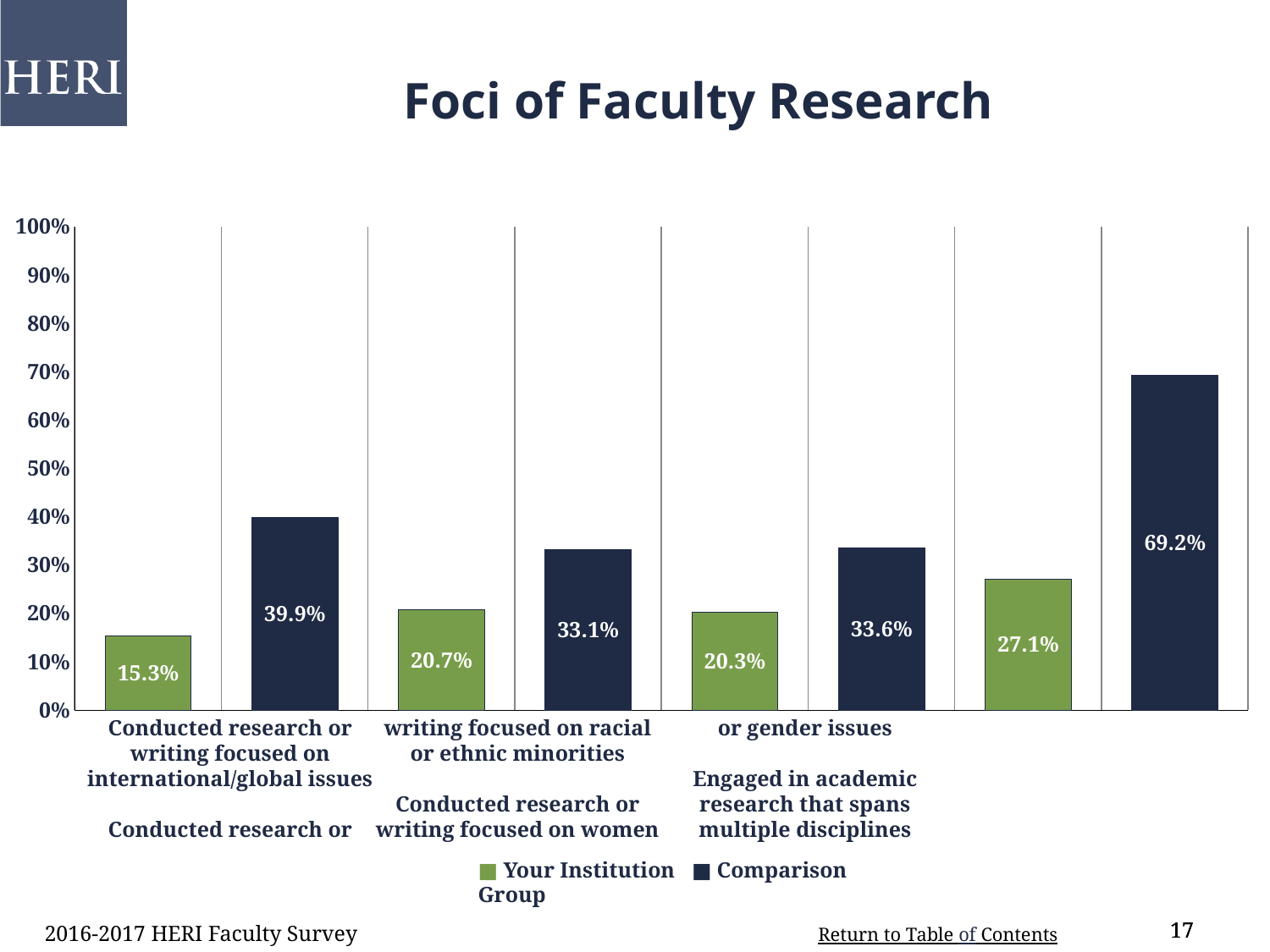
What is the Your Institution value for research or writing focused on international/global issues? 15.3% What kind of chart is shown on the slide? Bar chart How many series does the legend list? 2 Which category has the lowest Your Institution value? Conducted research or writing focused on international/global issues Which category has the highest Comparison Group value? Engaged in academic research that spans multiple disciplines What is the difference between the Comparison Group and Your Institution values for research that spans multiple disciplines? 42.1% How many categories are shown on the chart? 4 Which is larger for research focused on international/global issues: Your Institution or Comparison Group? Comparison Group Is the Comparison Group value for research that spans multiple disciplines greater or less than 60%? greater What is the Comparison Group value for academic research that spans multiple disciplines? 69.2% What is the Your Institution value for research or writing focused on women or gender issues? 20.3% What is the Comparison Group value for research or writing focused on racial or ethnic minorities? 33.1%